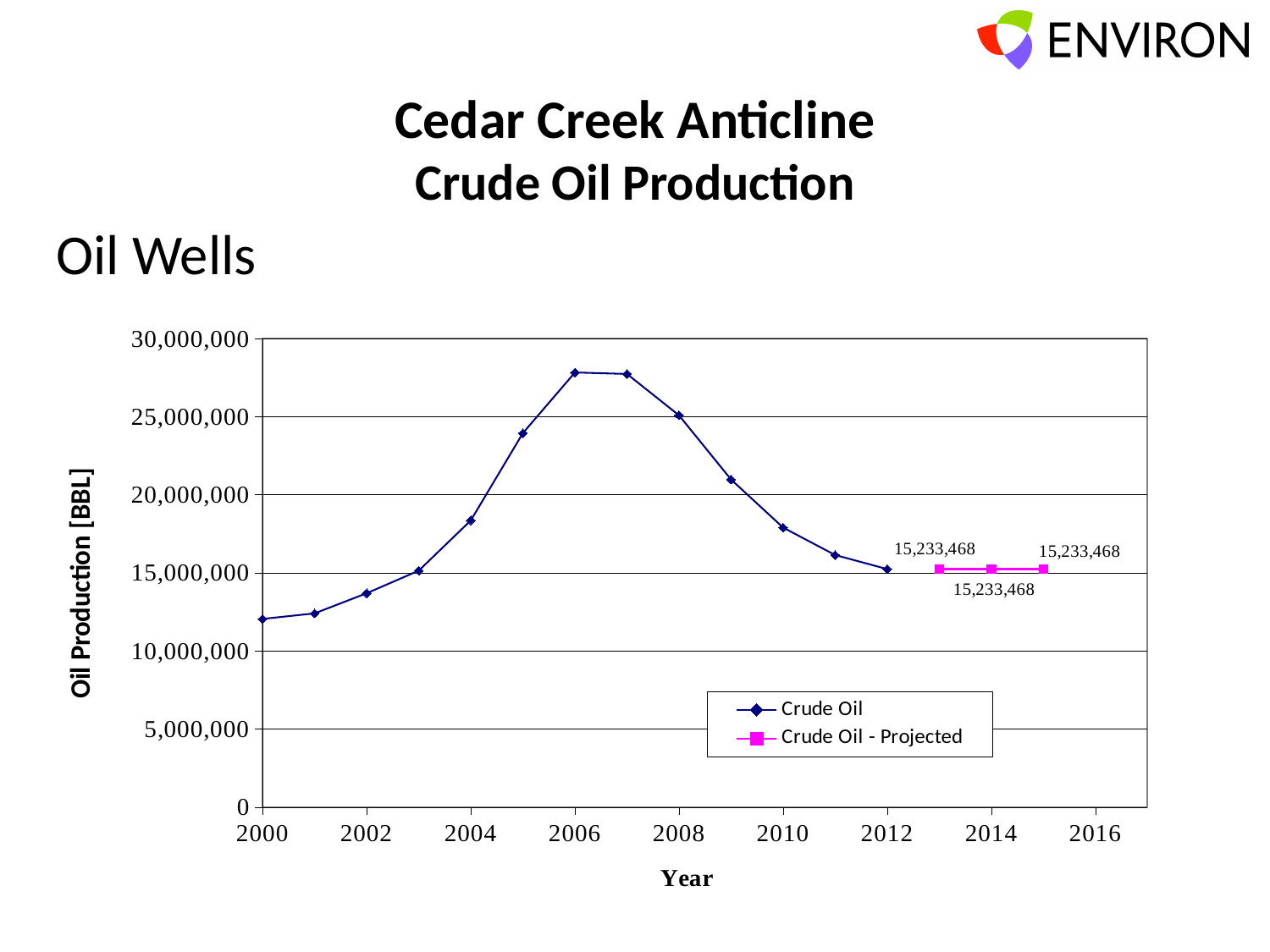
What kind of chart is shown on the slide? line chart Does the Crude Oil series rise or fall from 2007 to 2012? fall What is the title of the vertical axis? Oil Production [BBL] How many series does the legend list? 2 What is the difference between the projected crude oil production for 2015 and for 2013? 0 How many data points does the Crude Oil - Projected series have? 3 Is the Crude Oil value for 2006 greater or less than 25,000,000? greater Which year has the larger Crude Oil value, 2005 or 2009? 2005 What is the projected crude oil production for 2013? 15,233,468 Is the Crude Oil value for 2010 greater or less than 15,000,000? greater What is the projected crude oil production for 2015? 15,233,468 Is the Crude Oil value for 2000 greater or less than 15,000,000? less